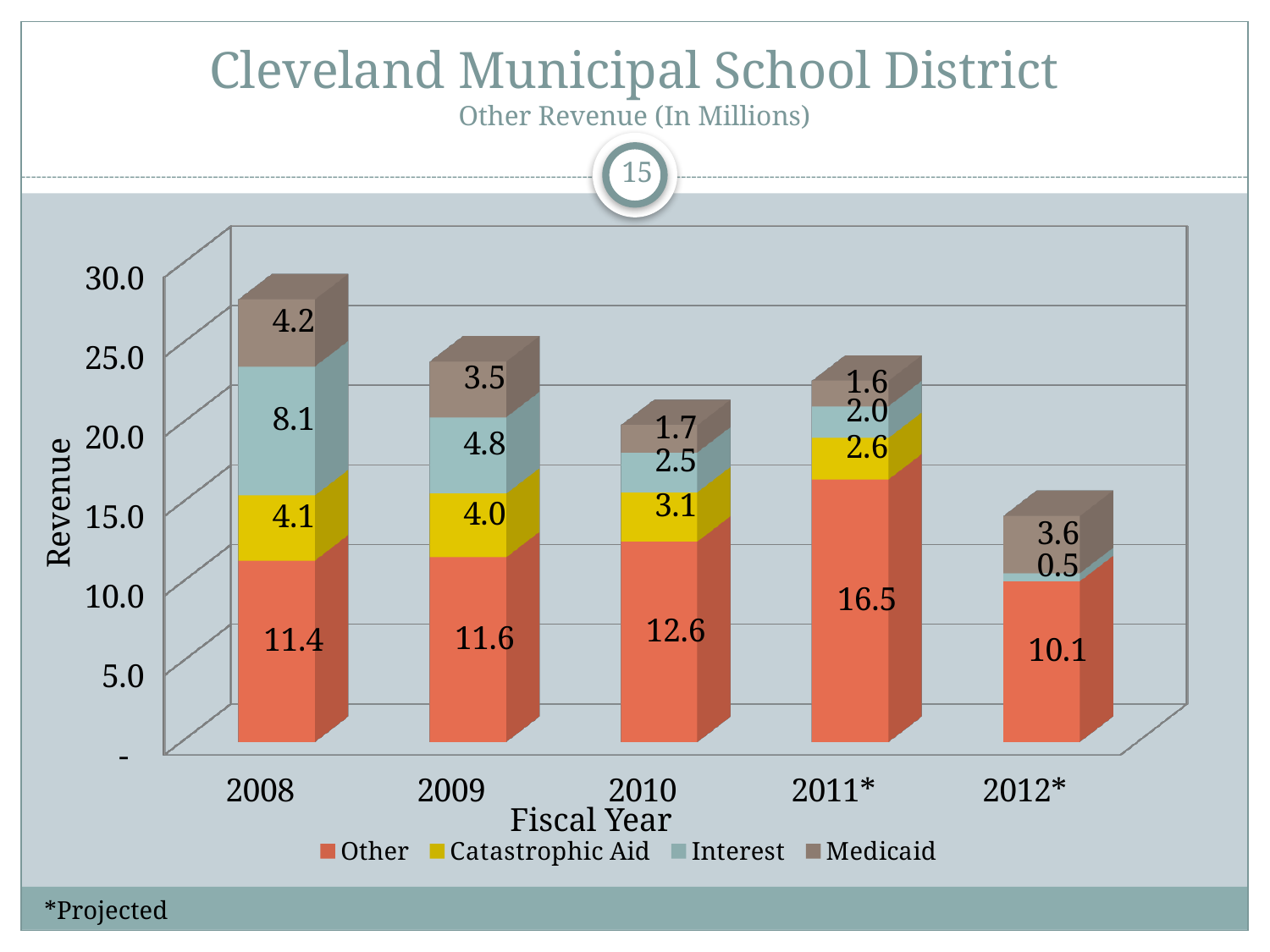
Which fiscal year has the larger Catastrophic Aid value, 2008 or 2009? 2008 How many fiscal years are shown on the x axis? 5 What is the difference between the Interest values for 2008 and 2009? 3.3 What kind of chart is shown on the slide? Stacked bar chart What is the value of the Other series for fiscal year 2008? 11.4 In which fiscal year is the Interest series lowest? 2012* What is the Interest value for fiscal year 2009? 4.8 How many series does the legend list? 4 What is the Medicaid value for fiscal year 2011*? 1.6 In which fiscal year is the Other series highest? 2011* What is the total of the stacked bar for fiscal year 2008? 27.8 Does the Interest series rise or fall from 2008 to 2011*? Fall